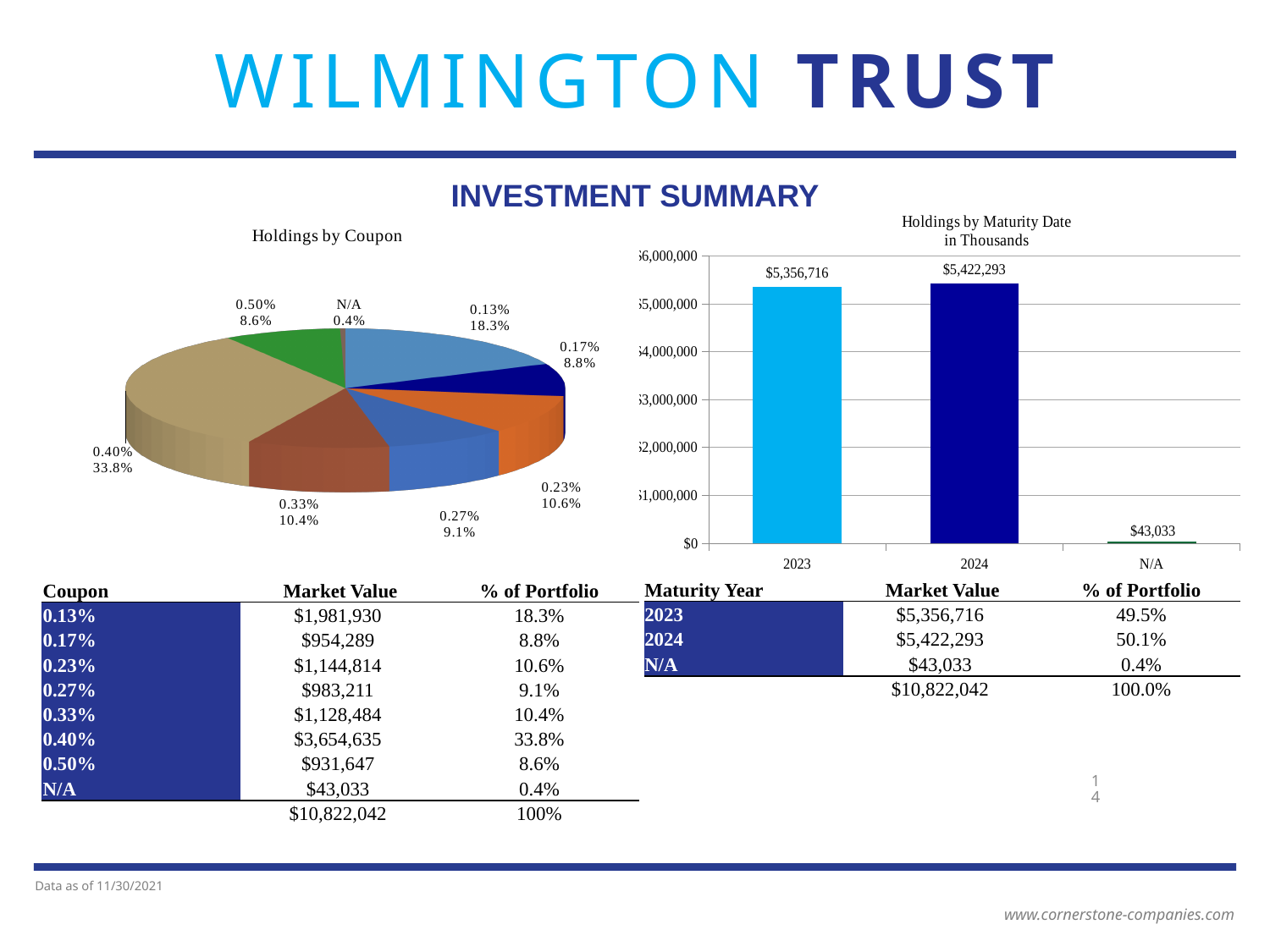
In the Holdings by Coupon chart, how many slices does the pie have? 8 In the Holdings by Coupon chart, what share of the pie does the 0.40% coupon slice represent? 33.8% In the Holdings by Maturity Date chart, what is the value for N/A? $43,033 In the Holdings by Maturity Date chart, is the value for 2023 greater or less than $5,000,000? greater In the Holdings by Coupon chart, what share of the pie does the 0.13% coupon slice represent? 18.3% In the Holdings by Maturity Date chart, what is the difference between the 2024 and 2023 values? $65,577 In the Holdings by Coupon chart, which coupon slice is the largest? 0.40% In the Holdings by Maturity Date chart, how many bars are plotted? 3 In the Holdings by Coupon chart, which slice is the smallest? N/A What kind of chart is Holdings by Maturity Date? Bar chart In the Holdings by Maturity Date chart, what is the value for 2024? $5,422,293 What kind of chart is Holdings by Coupon? Pie chart